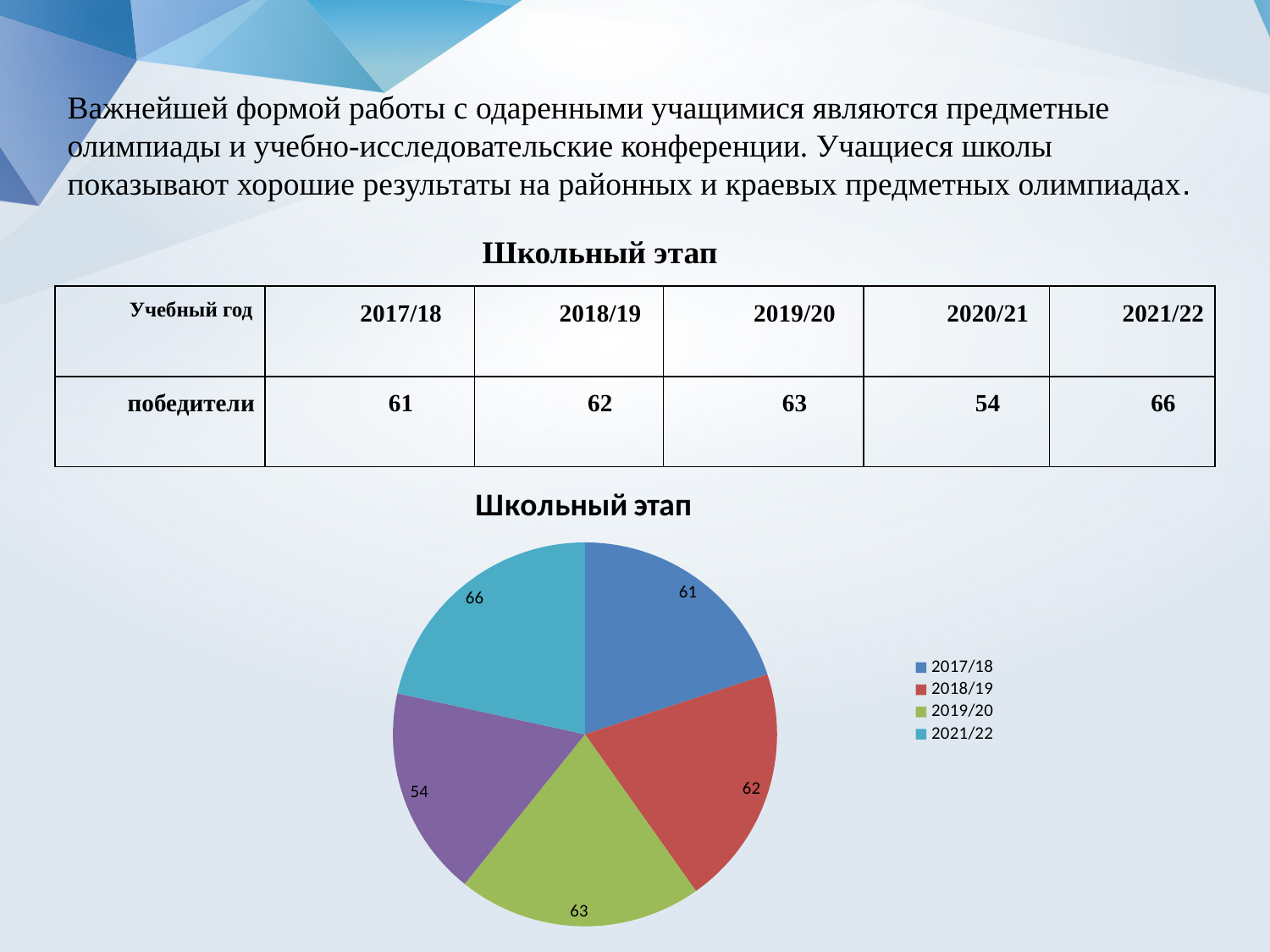
Which year has the largest slice in the pie chart? 2021/22 Which is larger in the pie chart, the 2019/20 slice or the 2018/19 slice? 2019/20 What kind of chart is shown on the slide? pie chart What is the value of the 2021/22 slice in the pie chart? 66 What is the value of the 2018/19 slice in the pie chart? 62 What is the value of the 2017/18 slice in the pie chart? 61 What is the title of the chart? Школьный этап What is the value of the 2019/20 slice in the pie chart? 63 How many slices does the pie chart have? 5 How many entries does the chart legend list? 4 What is the value of the smallest slice in the pie chart? 54 What is the difference between the 2021/22 slice and the 2017/18 slice? 5